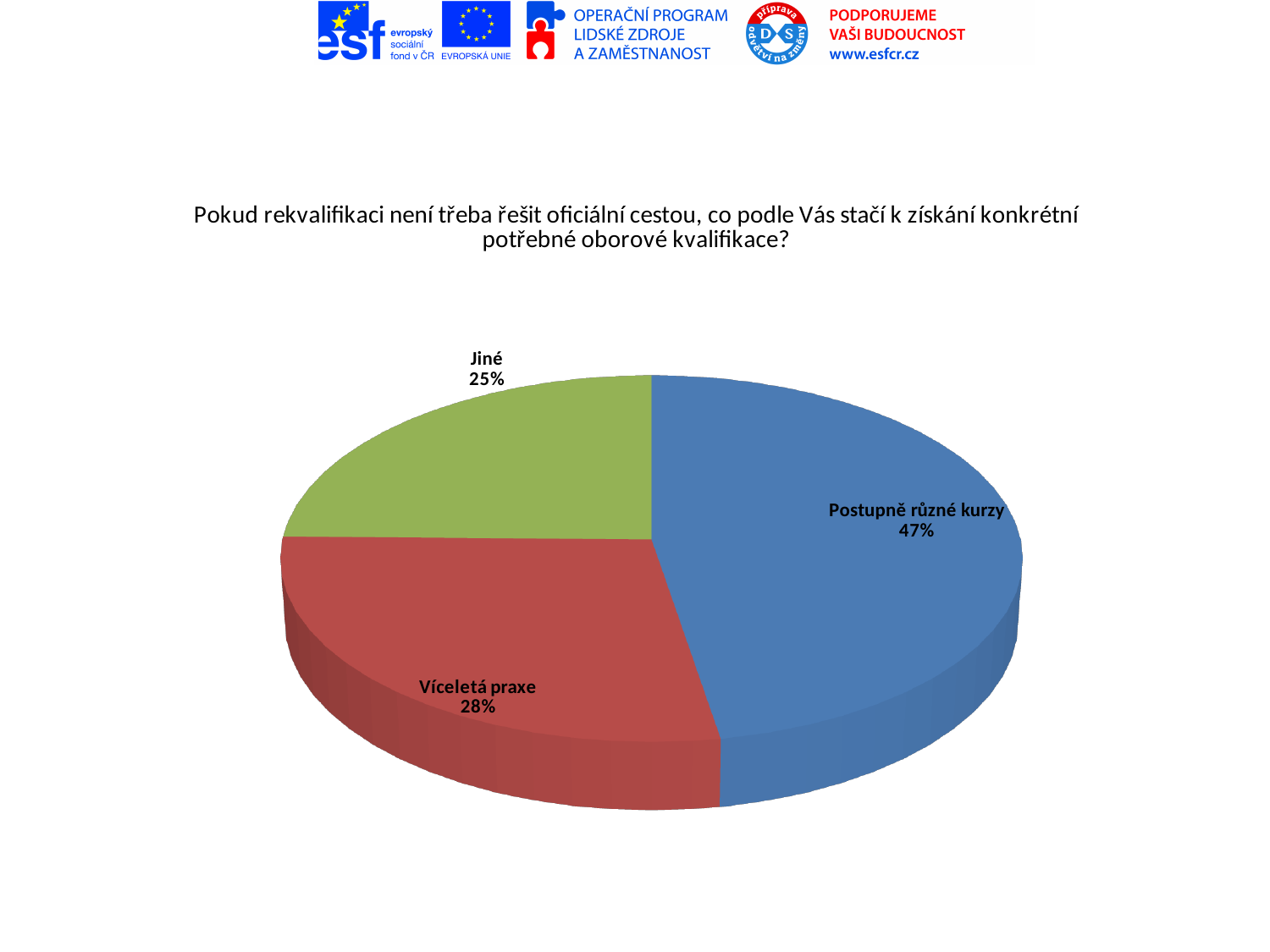
What is the difference in percentage points between "Víceletá praxe" and "Jiné"? 3 What colour is the slice for "Jiné"? green How many slices does the pie chart have? 3 What share of the pie does "Postupně různé kurzy" have? 47% What share of the pie does "Víceletá praxe" have? 28% What is the difference in percentage points between "Postupně různé kurzy" and "Víceletá praxe"? 19 What kind of chart is shown on the slide? pie chart Which category has the smallest slice of the pie? Jiné Which is larger, the share for "Víceletá praxe" or the share for "Jiné"? Víceletá praxe What colour is the slice for "Postupně různé kurzy"? blue What share of the pie does "Jiné" have? 25% Which category has the largest slice of the pie? Postupně různé kurzy